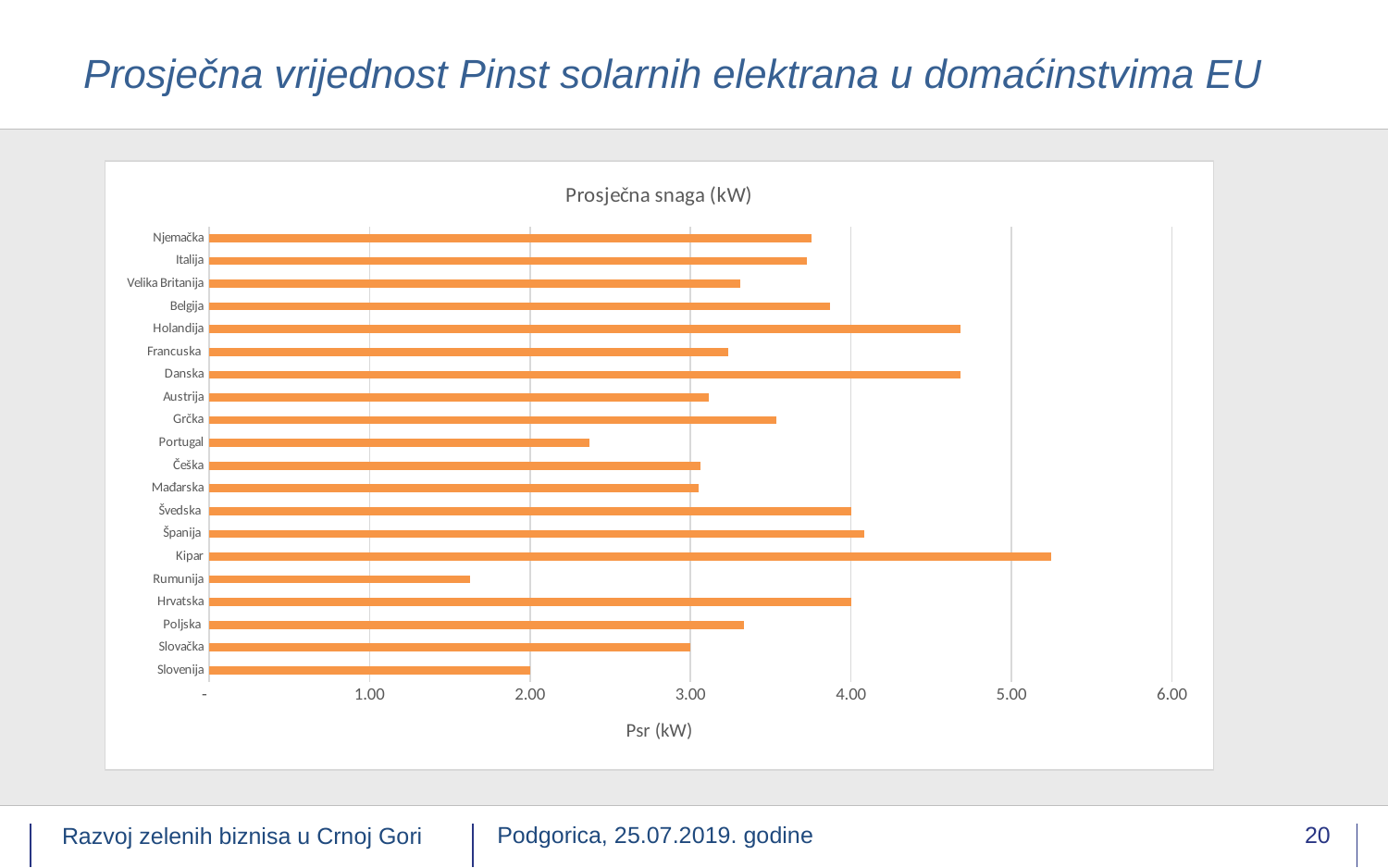
What is the label of the horizontal axis? Psr (kW) Is the value for Kipar greater or less than 5.00? greater Which country has the highest average power (Prosječna snaga) in the chart? Kipar Which has a larger value, Grčka or Portugal? Grčka Is the value for Njemačka greater or less than 4.00? less Is the value for Holandija greater or less than 4.00? greater Which has a larger value, Holandija or Francuska? Holandija What is the title of the chart? Prosječna snaga (kW) Which country has the lowest average power in the chart? Rumunija What kind of chart is shown on the slide? bar chart How many countries are listed in the chart? 20